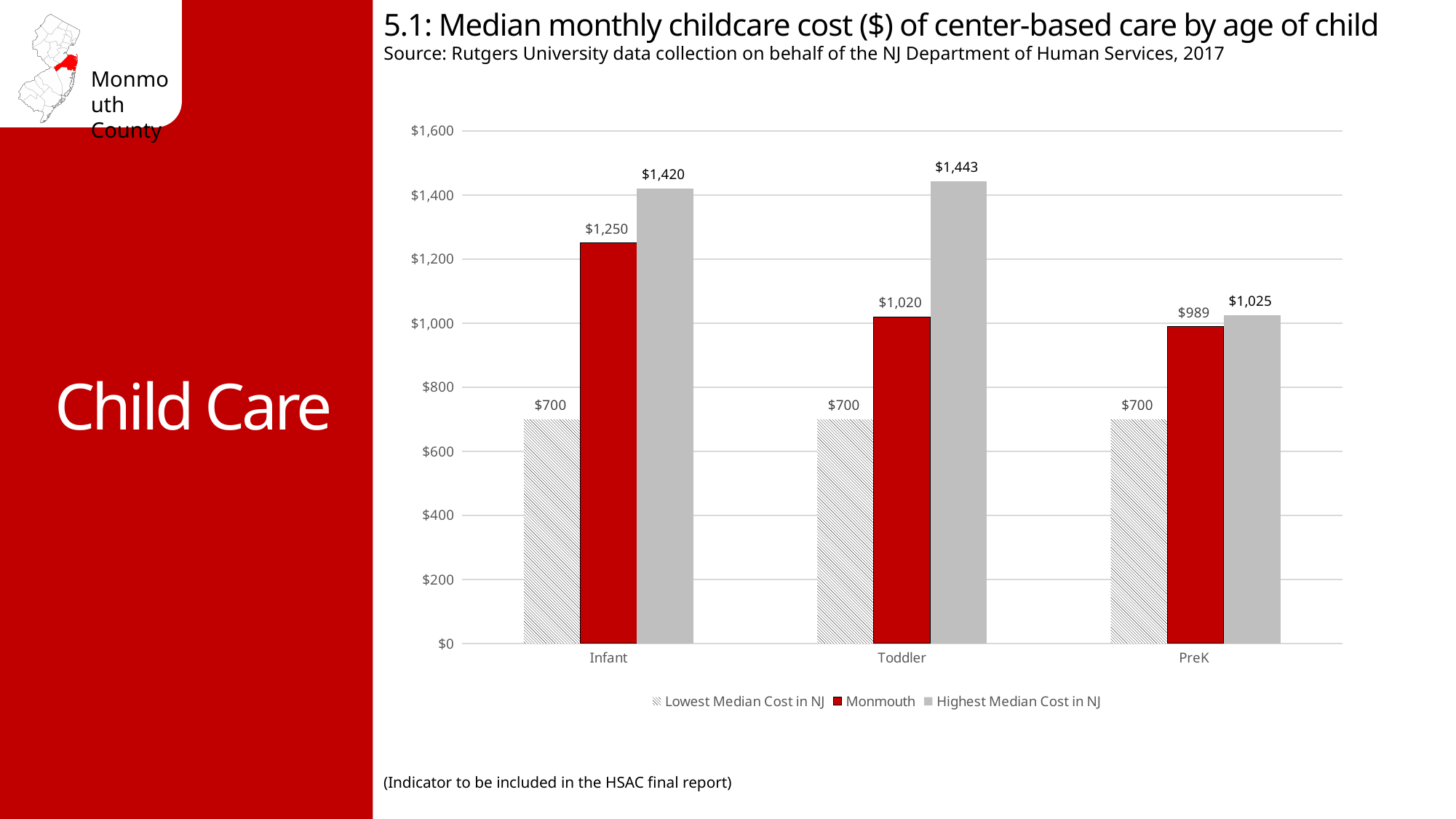
What is the difference between the Monmouth value and the Lowest Median Cost in NJ for Toddler care? $320 What kind of chart is shown on the slide? Bar chart What is the Monmouth median monthly childcare cost for Infant care? $1,250 How many series does the legend list? 3 Do the Monmouth values rise or fall from Infant to PreK? Fall What is the Monmouth value for PreK? $989 Which is larger for Toddler care: the Monmouth value or the Highest Median Cost in NJ? Highest Median Cost in NJ Which age group has the highest Monmouth median monthly cost? Infant What is the Highest Median Cost in NJ for Toddler care? $1,443 How many age groups are shown on the x axis? 3 Which age group has the lowest Highest Median Cost in NJ? PreK What is the difference between the Highest Median Cost in NJ and the Monmouth value for Infant care? $170